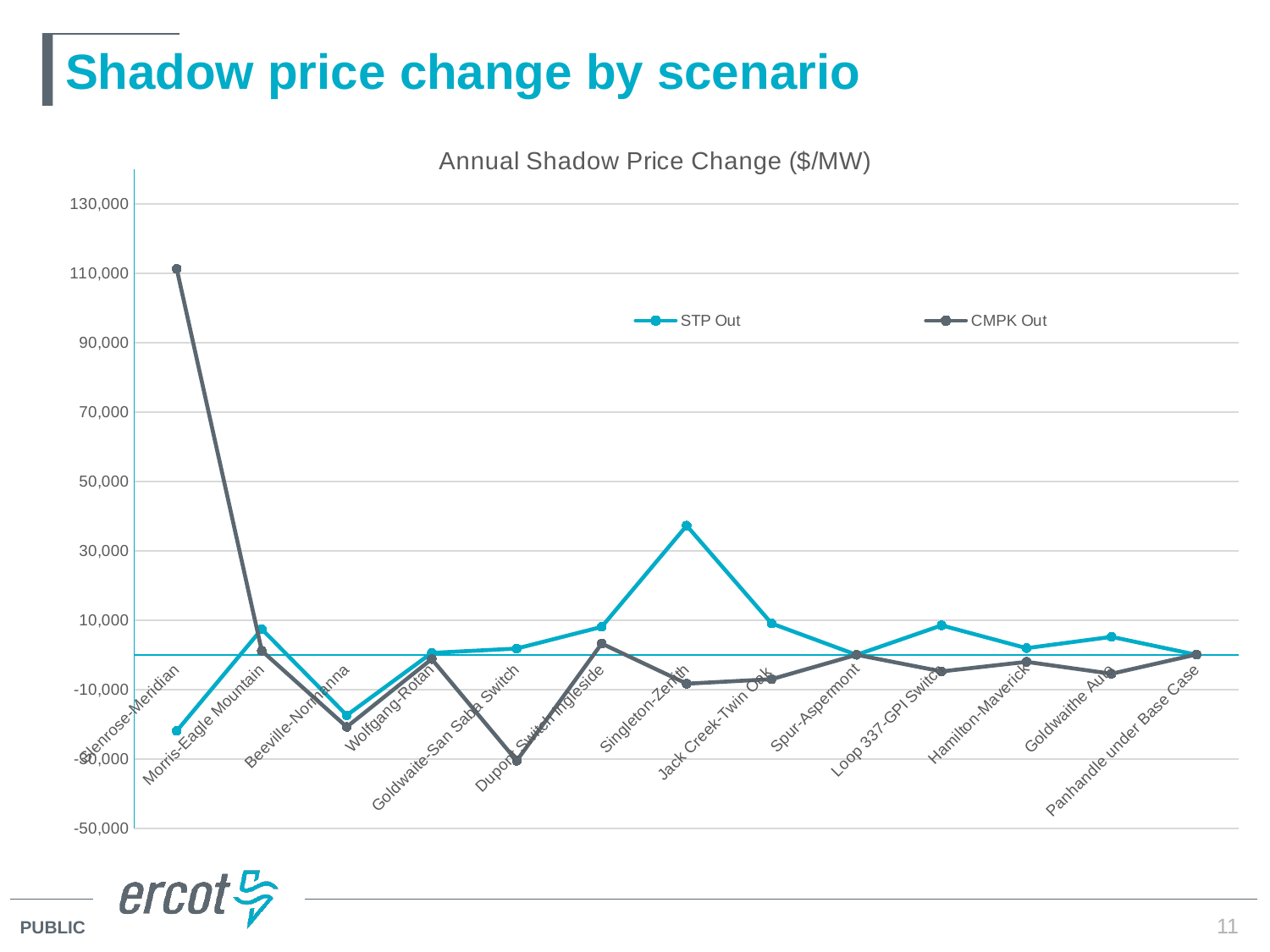
What is the title of the chart? Annual Shadow Price Change ($/MW) For which category is the CMPK Out value highest? Glenrose-Meridian Is the CMPK Out value for Glenrose-Meridian greater or less than 90,000? greater For which category is the STP Out value highest? Singleton-Zenith At Glenrose-Meridian, which series has the larger value, STP Out or CMPK Out? CMPK Out Is the STP Out value for Singleton-Zenith greater or less than 30,000? greater How many series does the legend list? 2 How many categories are plotted along the x axis? 13 Is the CMPK Out value for Dupont Switch-Ingleside greater or less than -10,000? greater What are the two series named in the legend? STP Out and CMPK Out What kind of chart is shown on the slide? line chart For which category is the CMPK Out value lowest? Goldwaite-San Saba Switch